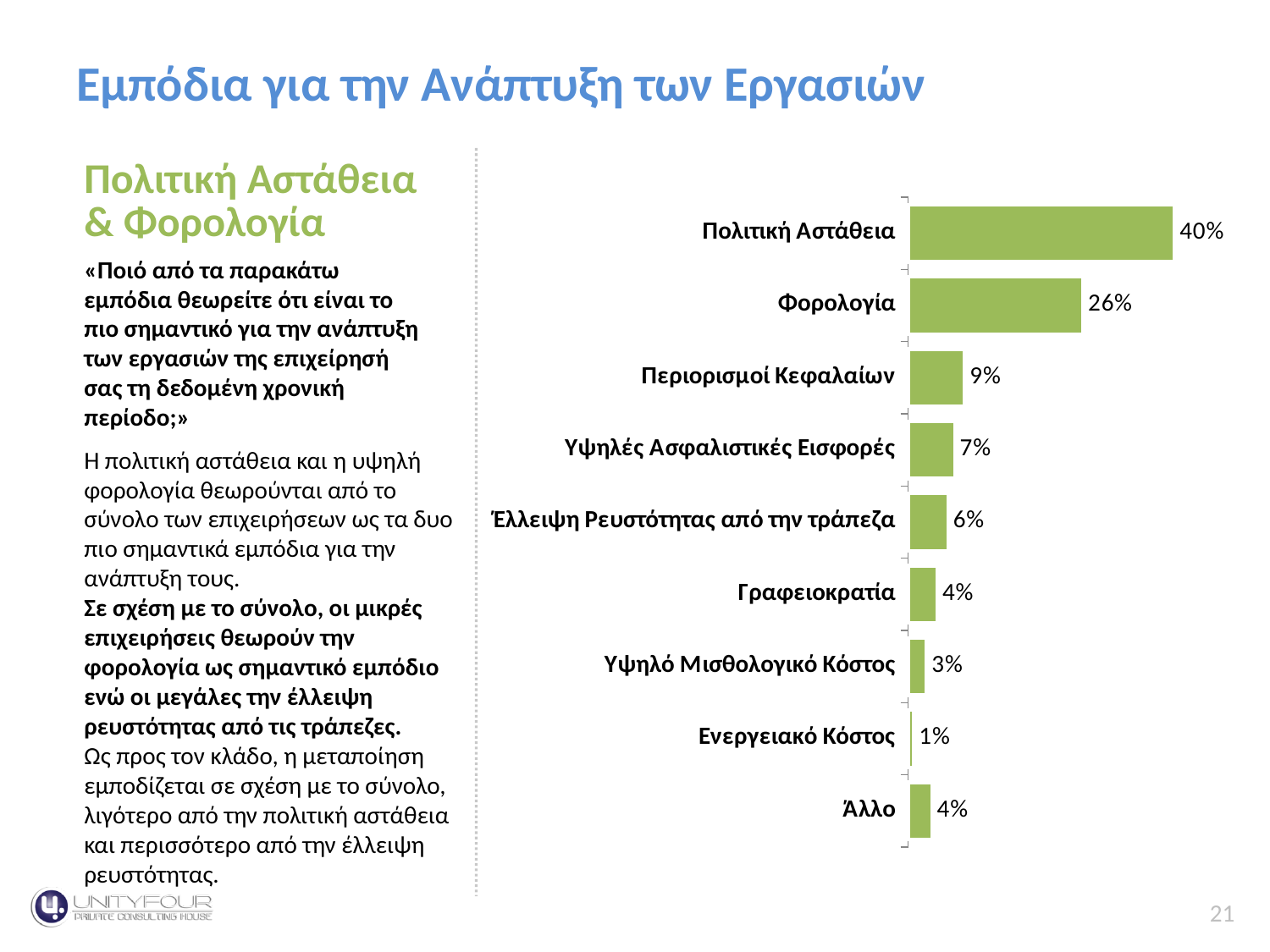
What is the difference between the values for Πολιτική Αστάθεια and Φορολογία? 14% What is the value for Ενεργειακό Κόστος? 1% Which category has the highest value? Πολιτική Αστάθεια What is the difference between the values for Περιορισμοί Κεφαλαίων and Υψηλές Ασφαλιστικές Εισφορές? 2% What colour are the bars in the chart? Green What is the value for Πολιτική Αστάθεια? 40% What kind of chart is shown on the slide? Bar chart Which is larger, the value for Γραφειοκρατία or the value for Υψηλό Μισθολογικό Κόστος? Γραφειοκρατία How many categories are shown in the chart? 9 Which category has the lowest value? Ενεργειακό Κόστος What is the value for Έλλειψη Ρευστότητας από την τράπεζα? 6% What is the value for Φορολογία? 26%